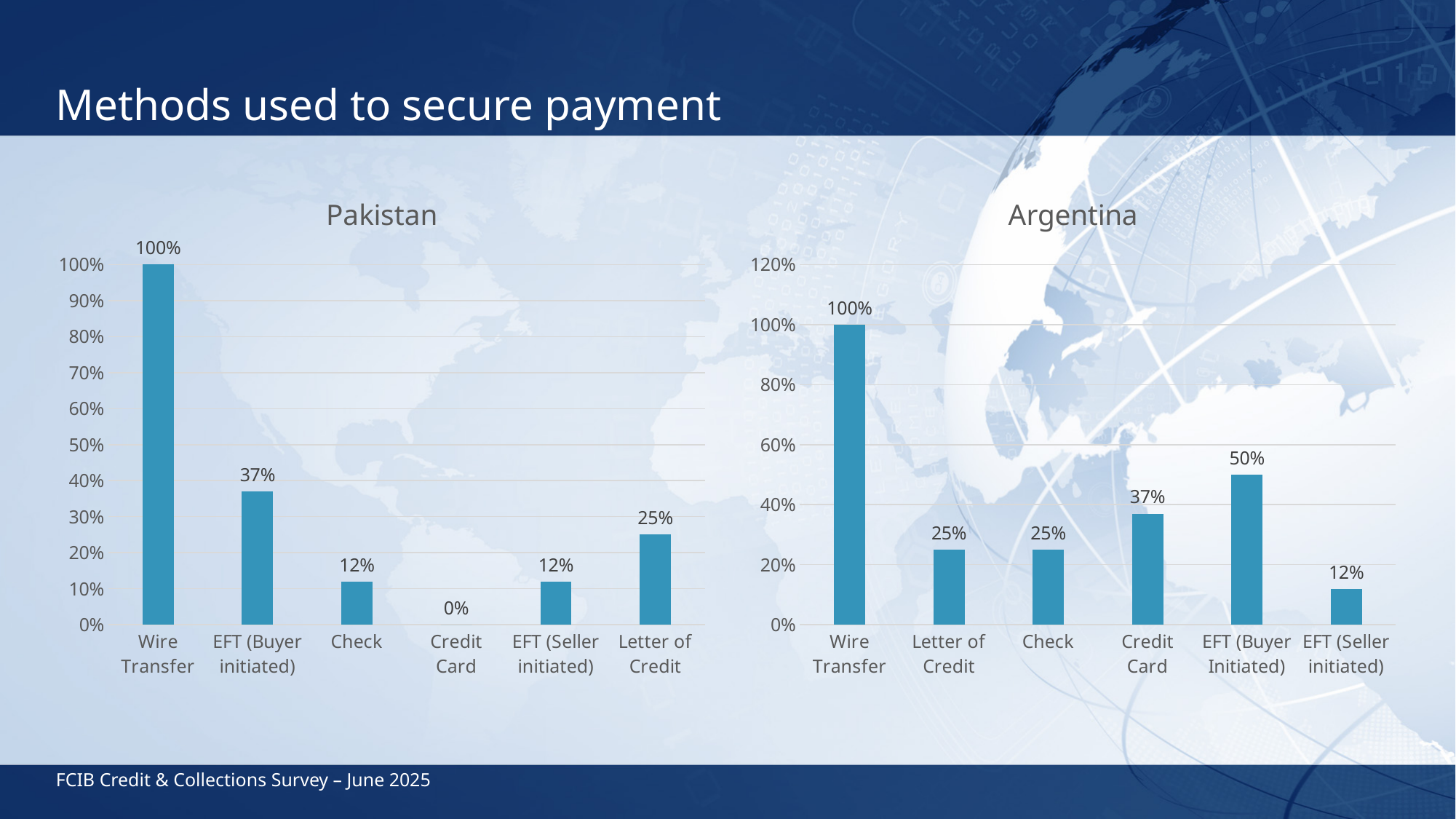
In the Pakistan chart, which is larger, Check or Letter of Credit? Letter of Credit In the Argentina chart, which category has the lowest value? EFT (Seller initiated) What is the title of the slide? Methods used to secure payment In the Argentina chart, what is the difference between EFT (Buyer Initiated) and EFT (Seller initiated)? 38% In the Pakistan chart, what is the value for EFT (Buyer initiated)? 37% In the Argentina chart, what is the value for Credit Card? 37% In the Argentina chart, which is larger, Credit Card or EFT (Buyer Initiated)? EFT (Buyer Initiated) In the Argentina chart, which category has the highest value? Wire Transfer How many categories are shown in the Pakistan chart? 6 In the Pakistan chart, which category has the lowest value? Credit Card What kind of chart is the Argentina chart? Bar chart In the Pakistan chart, what is the difference between Wire Transfer and Letter of Credit? 75%